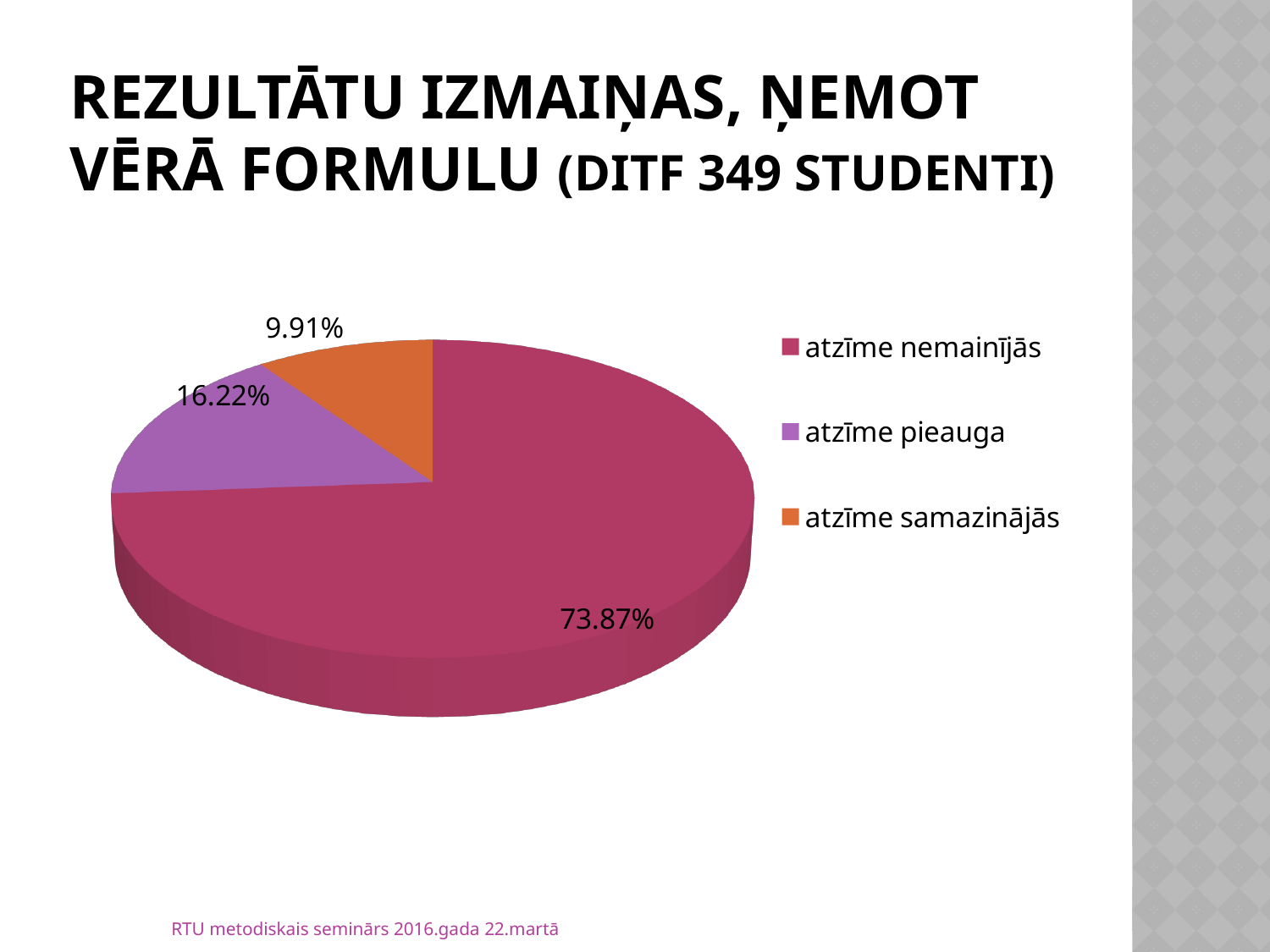
Which is larger, the slice for "atzīme pieauga" or the slice for "atzīme samazinājās"? atzīme pieauga How many slices does the pie chart have? 3 How many entries does the legend list? 3 What is the difference in percentage points between the "atzīme pieauga" slice and the "atzīme samazinājās" slice? 6.31 What share of the pie does "atzīme nemainījās" take? 73.87% What kind of chart is shown on the slide? Pie chart What share of the pie does "atzīme pieauga" take? 16.22% Which colour represents "atzīme samazinājās" in the pie chart? Orange Which category has the smallest slice of the pie? atzīme samazinājās Which category has the largest slice of the pie? atzīme nemainījās What is the difference in percentage points between the "atzīme nemainījās" slice and the "atzīme pieauga" slice? 57.65 What share of the pie does "atzīme samazinājās" take? 9.91%